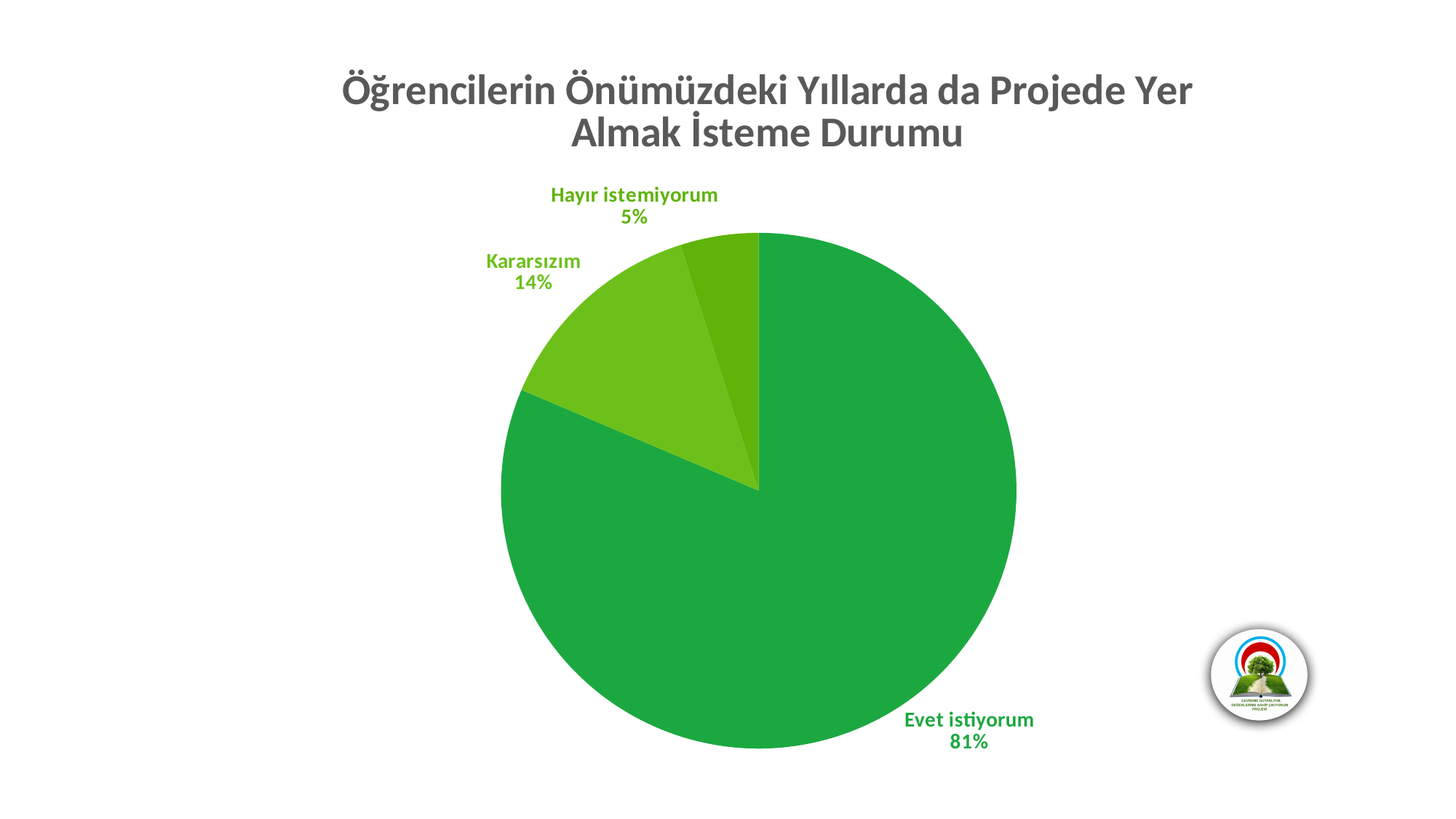
What is the difference in percentage points between "Evet istiyorum" and "Kararsızım"? 67 What is the title of the chart? Öğrencilerin Önümüzdeki Yıllarda da Projede Yer Almak İsteme Durumu What percentage of students answered "Evet istiyorum"? 81% What is the difference in percentage points between "Kararsızım" and "Hayır istemiyorum"? 9 Which category has the smallest share of the pie? Hayır istemiyorum How many slices does the pie chart have? 3 What percentage of students answered "Hayır istemiyorum"? 5% Which is larger, the share for "Kararsızım" or the share for "Hayır istemiyorum"? Kararsızım What share of the pie does the "Evet istiyorum" slice represent? 81% What percentage of students answered "Kararsızım"? 14% Which category has the largest share of the pie? Evet istiyorum What type of chart is shown on the slide? pie chart